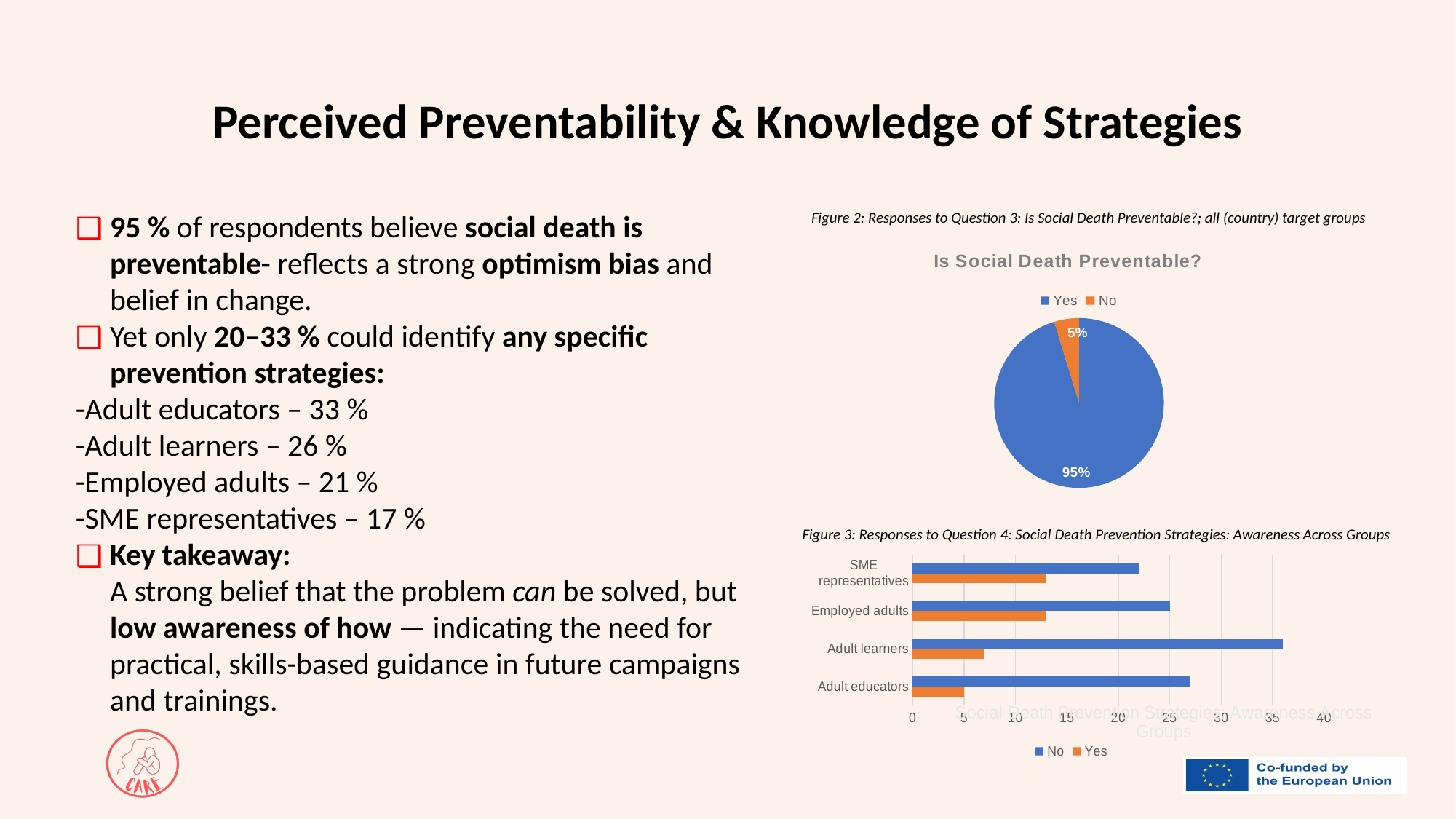
What type of chart is the lower chart on the slide (Figure 3)? Bar chart In the bar chart in Figure 3, is the 'No' value for Adult learners greater or less than 30? greater In the bar chart in Figure 3, which group has the highest 'No' value? Adult learners In the bar chart in Figure 3, which group has the lowest 'Yes' value? Adult educators In the bar chart in Figure 3, which colour represents the 'Yes' series? Orange How many groups are shown on the y axis of the bar chart in Figure 3? 4 In the pie chart 'Is Social Death Preventable?', what percentage of respondents answered Yes? 95% In the bar chart in Figure 3, is the 'Yes' value for Adult educators greater or less than 10? less How many series does the legend of the pie chart 'Is Social Death Preventable?' list? 2 In the bar chart in Figure 3, which is larger: the 'No' value for Adult learners or the 'No' value for Adult educators? Adult learners In the pie chart 'Is Social Death Preventable?', what percentage of respondents answered No? 5% In the pie chart 'Is Social Death Preventable?', what is the difference between the Yes and No shares? 90%